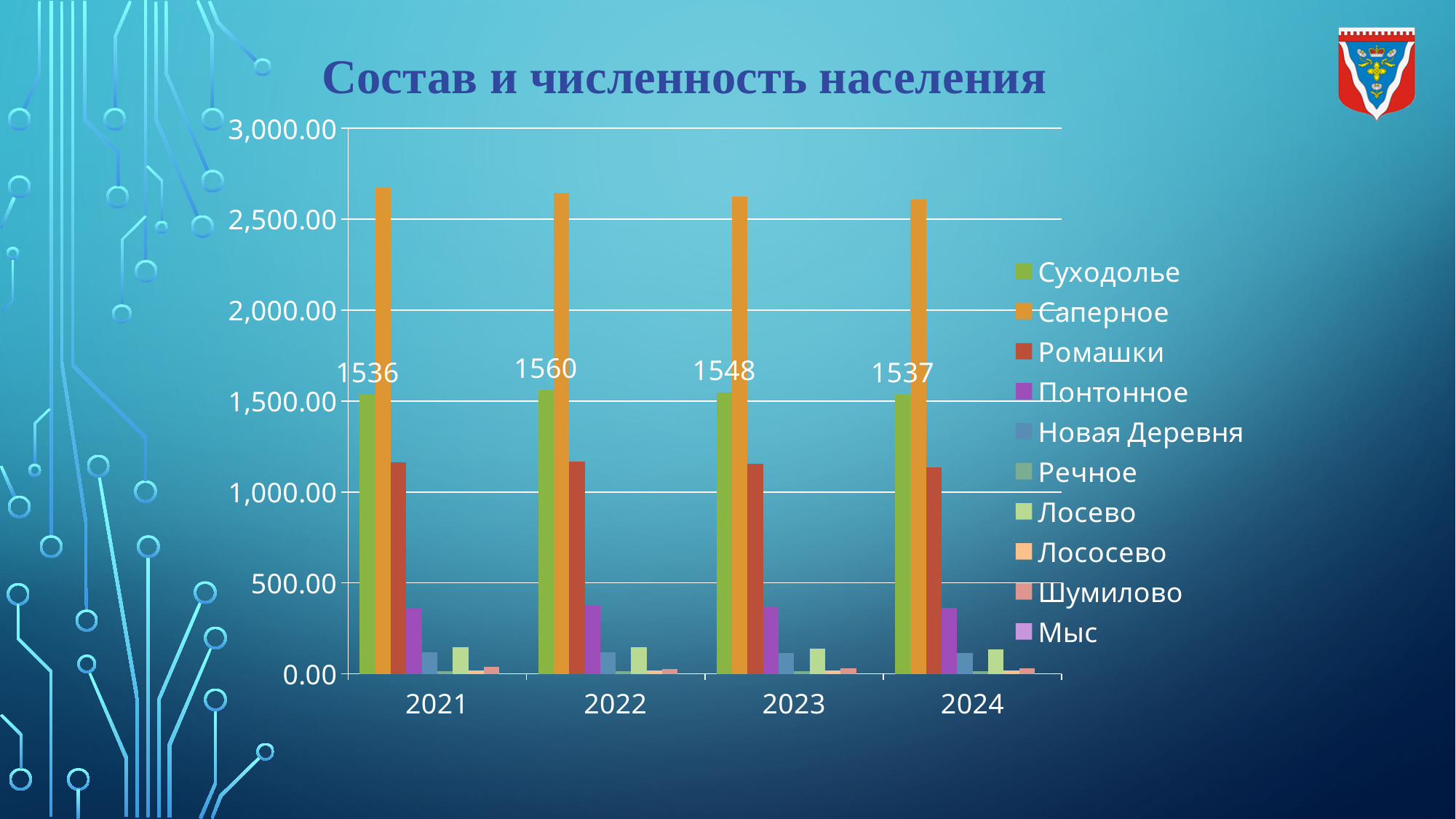
In which year is the value for Суходолье the highest? 2022 What is the value for Суходолье in 2024? 1537 Is the value for Понтонное in 2023 greater or less than 500.00? less Which series has the larger value in 2021, Саперное or Суходолье? Саперное How many years are shown on the x axis? 4 How many series does the legend list? 10 Is the value for Саперное in 2021 greater or less than 2,500.00? greater What kind of chart is shown on the slide? Bar chart What is the difference between the Суходолье values for 2022 and 2021? 24 What is the value for Суходолье in 2022? 1560 In which year is the value for Суходолье the lowest? 2021 What is the value for Суходолье in 2021? 1536